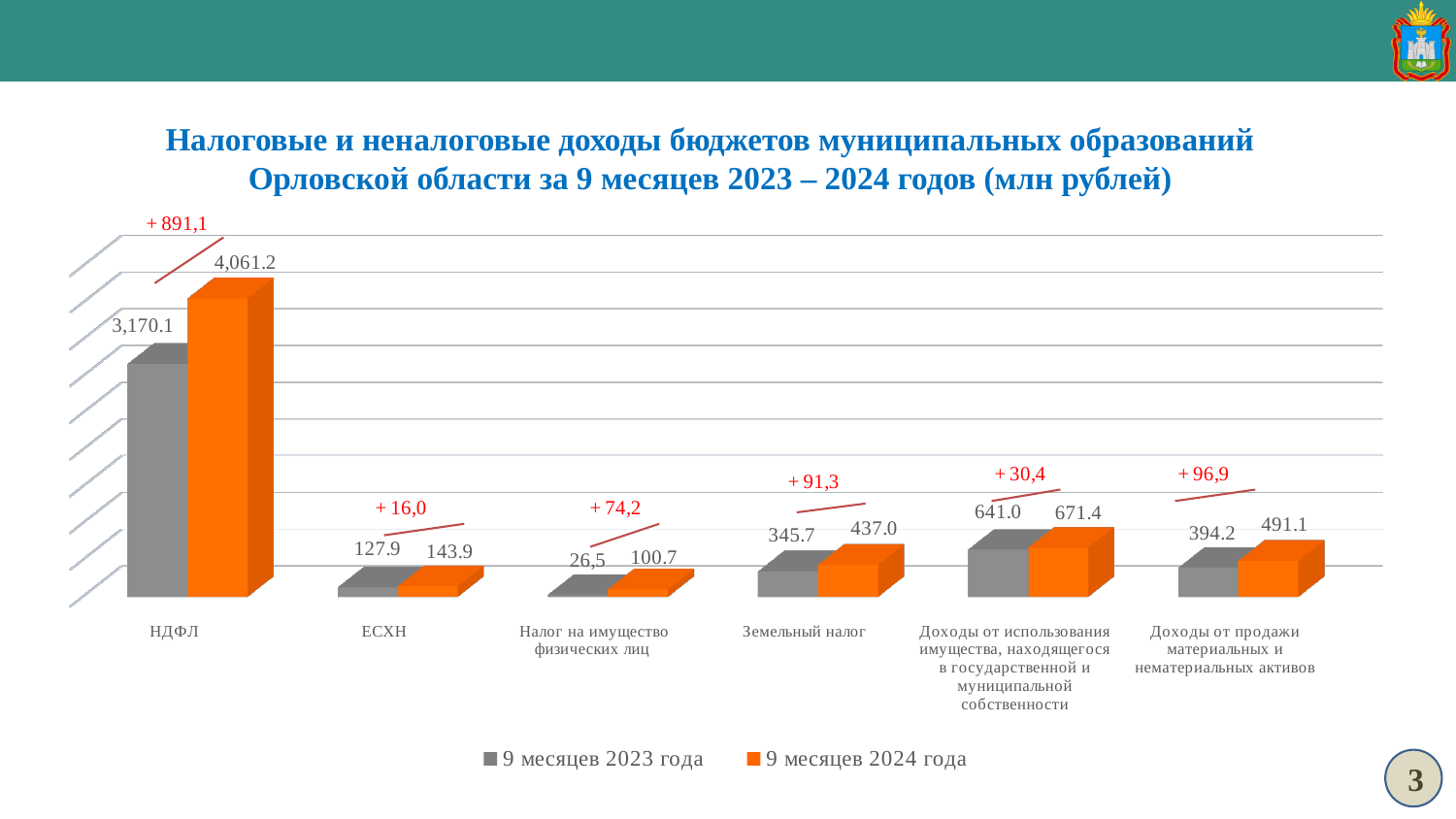
How many series does the legend list? 2 What is the value for Налог на имущество физических лиц in the 9 месяцев 2024 года series? 100.7 How many categories are shown on the x axis? 6 What is the value for Земельный налог in the 9 месяцев 2023 года series? 345.7 What kind of chart is shown on the slide? Bar chart What is the difference between the 2024 and 2023 values for ЕСХН? + 16,0 By how much did НДФЛ increase from 9 месяцев 2023 года to 9 месяцев 2024 года? + 891,1 Which is larger for Доходы от использования имущества: the 9 месяцев 2023 года value or the 9 месяцев 2024 года value? 9 месяцев 2024 года Which category has the lowest value in the 9 месяцев 2023 года series? Налог на имущество физических лиц What is the value for Доходы от продажи материальных и нематериальных активов in the 9 месяцев 2023 года series? 394.2 Which category has the highest value in the 9 месяцев 2024 года series? НДФЛ What is the value for НДФЛ in the 9 месяцев 2024 года series? 4,061.2